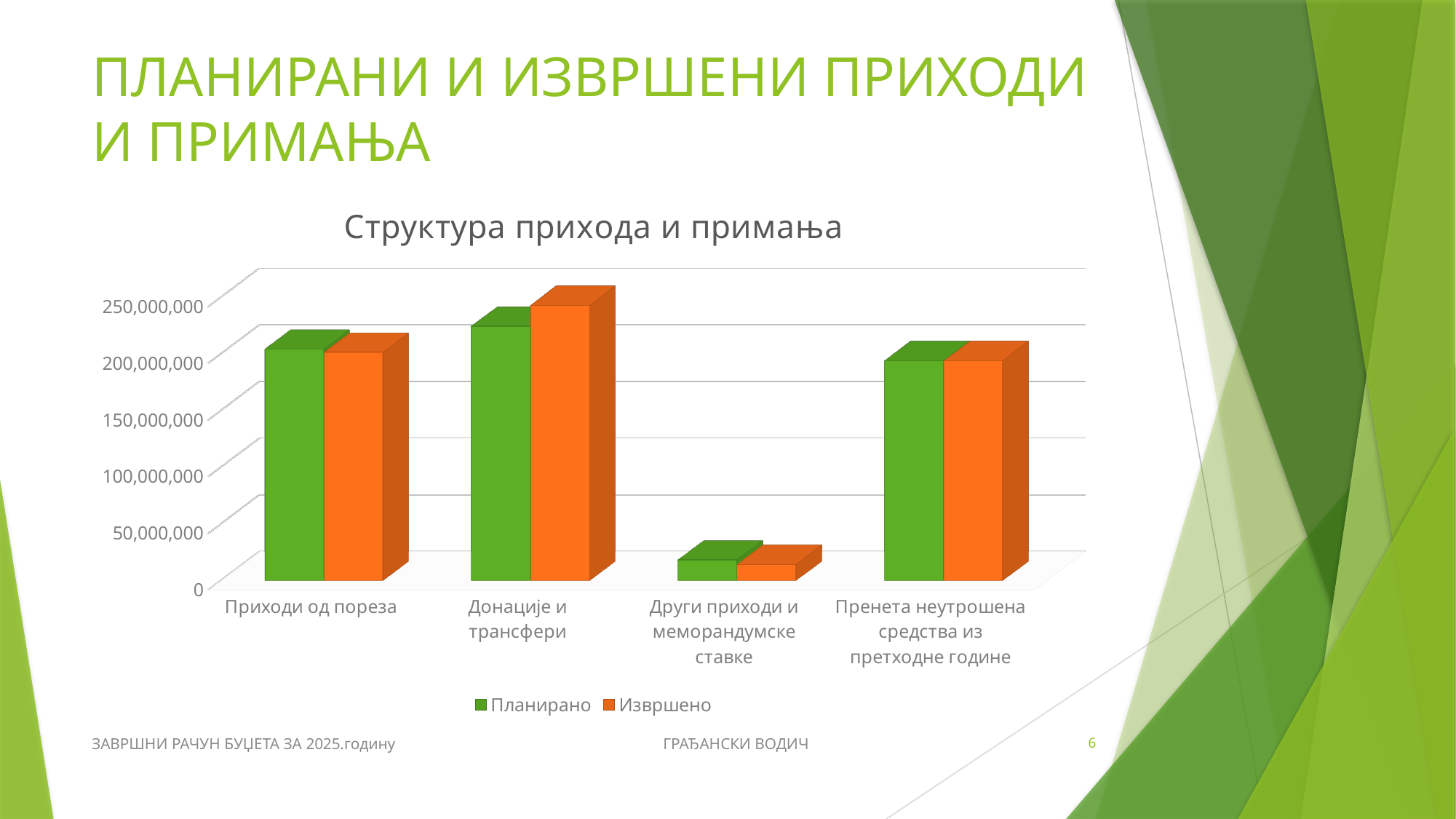
Which colour represents the Извршено series? orange How many series does the legend list? 2 Is the Планирано value for Други приходи и меморандумске ставке greater or less than 50,000,000? less Which category has the larger Извршено value: Приходи од пореза or Други приходи и меморандумске ставке? Приходи од пореза Which category has the highest Планирано value? Донације и трансфери How many categories are shown on the x axis? 4 Which is larger for Донације и трансфери: the Планирано value or the Извршено value? Извршено Is the Извршено value for Донације и трансфери greater or less than 200,000,000? greater What kind of chart is shown on the slide? bar chart Is the Планирано value for Приходи од пореза greater or less than 150,000,000? greater What is the title of the chart? Структура прихода и примања Which category has the lowest Извршено value? Други приходи и меморандумске ставке